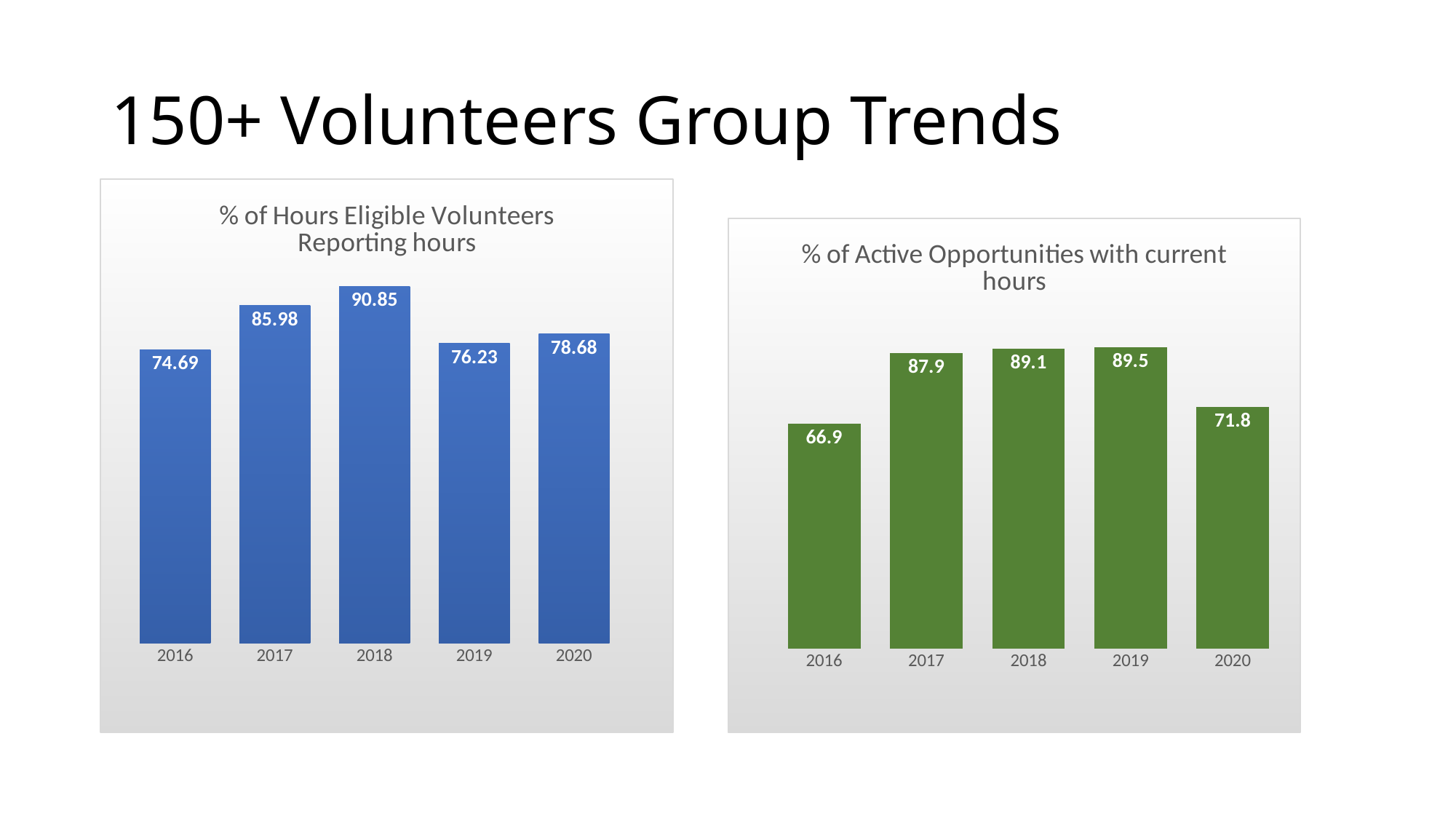
In the '% of Hours Eligible Volunteers Reporting hours' chart, which year has the lowest value? 2016 In the '% of Active Opportunities with current hours' chart, what is the difference between the 2019 and 2020 values? 17.7 What kind of chart is the '% of Hours Eligible Volunteers Reporting hours' chart? Bar chart In the '% of Active Opportunities with current hours' chart, what is the value for 2016? 66.9 In the '% of Active Opportunities with current hours' chart, which year has the highest value? 2019 In the '% of Hours Eligible Volunteers Reporting hours' chart, which is larger, the value for 2017 or the value for 2020? 2017 In the '% of Active Opportunities with current hours' chart, do the values rise or fall from 2016 to 2019? Rise How many years are shown in the '% of Active Opportunities with current hours' chart? 5 In the '% of Active Opportunities with current hours' chart, which is larger, the value for 2016 or the value for 2020? 2020 In the '% of Hours Eligible Volunteers Reporting hours' chart, what is the value for 2018? 90.85 What colour are the bars in the '% of Active Opportunities with current hours' chart? Green In the '% of Hours Eligible Volunteers Reporting hours' chart, what is the difference between the 2018 and 2019 values? 14.62